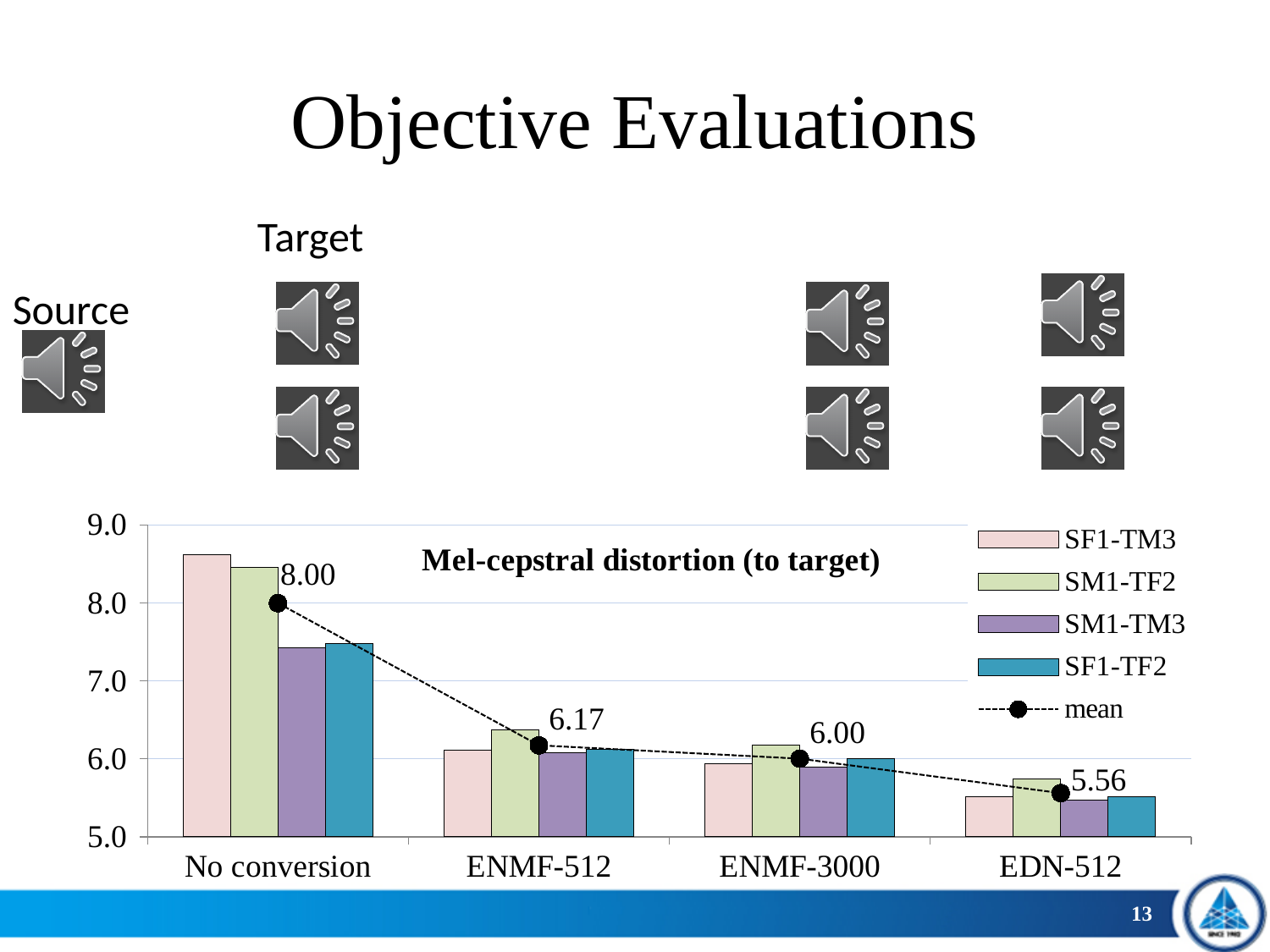
What is the mean value shown for EDN-512? 5.56 What is the mean value shown for the No conversion category? 8.00 Which has a larger mean value, ENMF-512 or ENMF-3000? ENMF-512 Does the mean value rise or fall from No conversion to EDN-512 along the x axis? fall Is the value for SF1-TM3 in the No conversion category greater or less than 8.0? greater Which category has the lowest mean value? EDN-512 How many categories are shown on the x axis? 4 How many entries does the legend list? 5 Which category has the highest mean value? No conversion What is the mean value shown for ENMF-3000? 6.00 What is the difference between the mean value for No conversion and the mean value for EDN-512? 2.44 What is the mean value shown for ENMF-512? 6.17